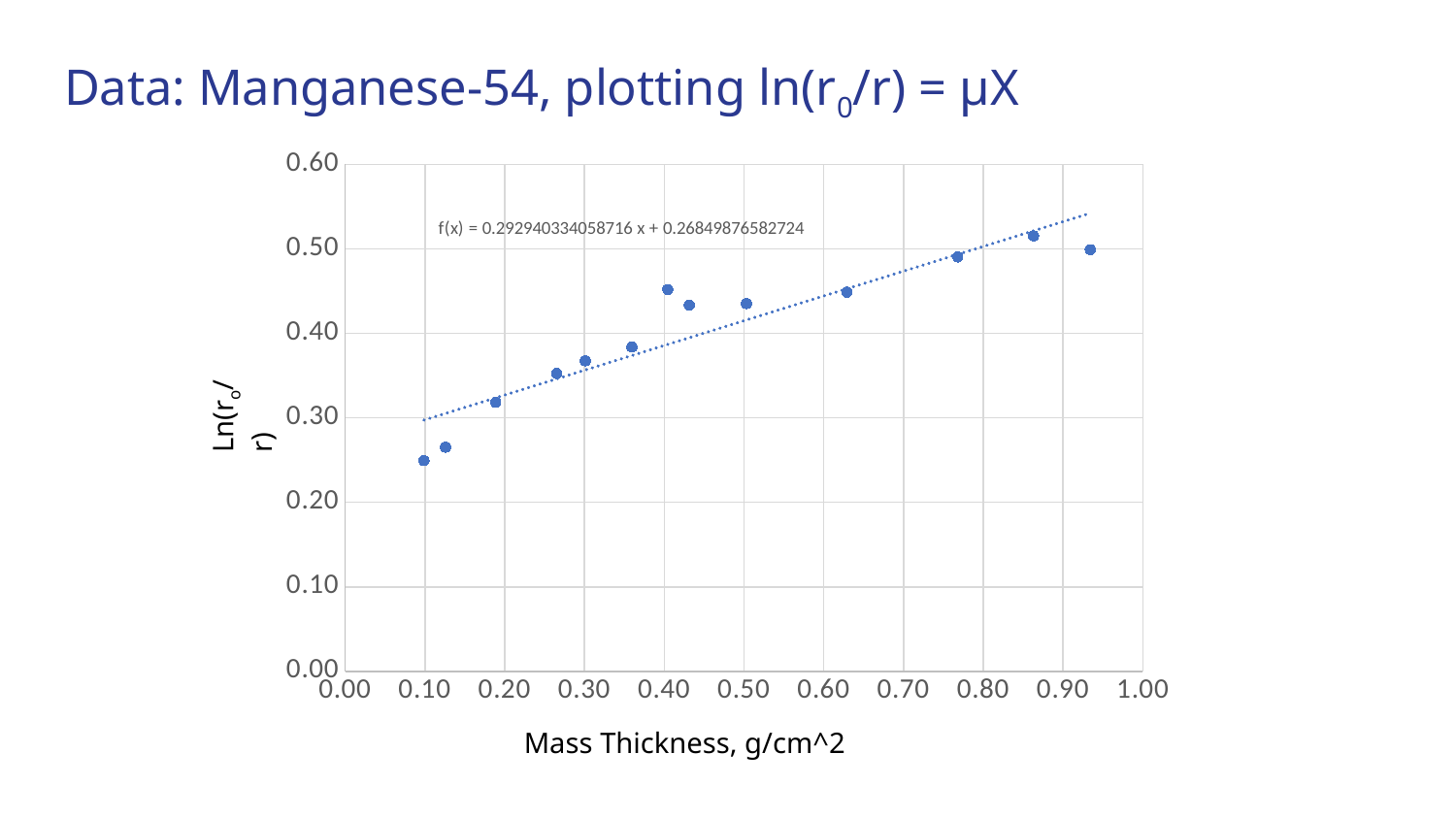
Which data point has the larger Ln(r0/r) value: the one near 0.10 g/cm^2 or the one near 0.77 g/cm^2? the one near 0.77 g/cm^2 Do the plotted values generally rise or fall as mass thickness increases along the x axis? rise What kind of chart is shown on the slide? scatter plot Is the value of Ln(r0/r) for the data point at mass thickness 0.10 g/cm^2 greater or less than 0.30? less What is the slope of the fitted trendline equation shown on the chart? 0.292940334058716 Is the value of Ln(r0/r) for the data point near mass thickness 0.19 g/cm^2 greater or less than 0.20? greater Is the value of Ln(r0/r) for the data point near mass thickness 0.63 g/cm^2 greater or less than 0.40? greater How many data points are plotted on the chart? 13 At which mass thickness does the lowest plotted value of Ln(r0/r) occur? 0.10 g/cm^2 What is the label of the x axis? Mass Thickness, g/cm^2